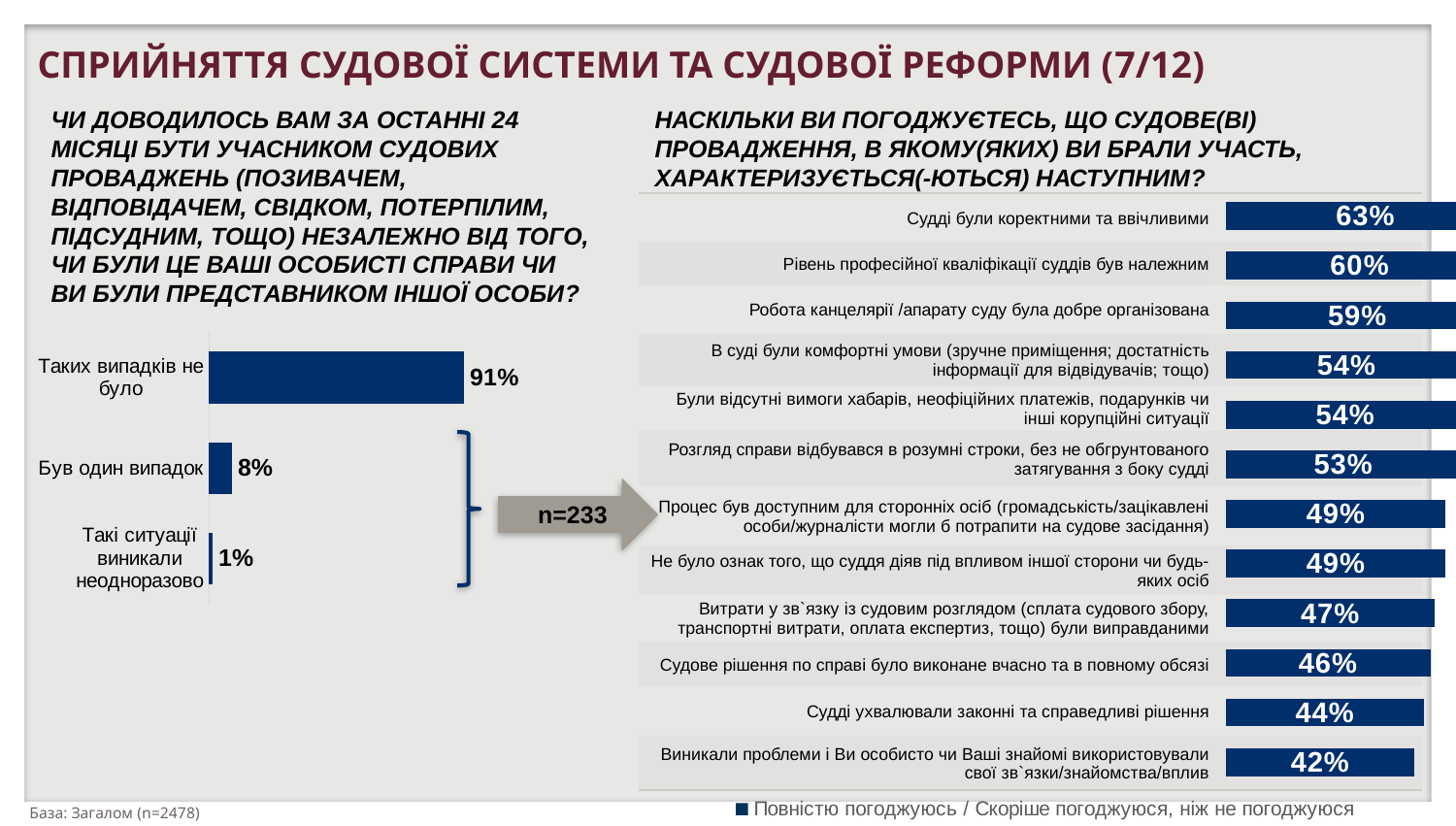
What type of chart is the right chart? Bar chart On the left chart, which category has the lowest value? Такі ситуації виникали неодноразово On the left chart, how many categories are shown? 3 On the right chart, which category has the highest value? Судді були коректними та ввічливими On the right chart, which is larger: "Рівень професійної кваліфікації суддів був належним" or "Судове рішення по справі було виконане вчасно та в повному обсязі"? Рівень професійної кваліфікації суддів був належним On the right chart, what is the value for "Судді були коректними та ввічливими"? 63% On the left chart, what is the value for "Таких випадків не було"? 91% On the right chart, what is the value for "Судді ухвалювали законні та справедливі рішення"? 44% On the left chart, what is the value for "Був один випадок"? 8% On the left chart, what is the difference between "Таких випадків не було" and "Був один випадок"? 83% On the right chart, how many categories are shown? 12 On the right chart, which category has the lowest value? Виникали проблеми і Ви особисто чи Ваші знайомі використовували свої зв`язки/знайомства/вплив